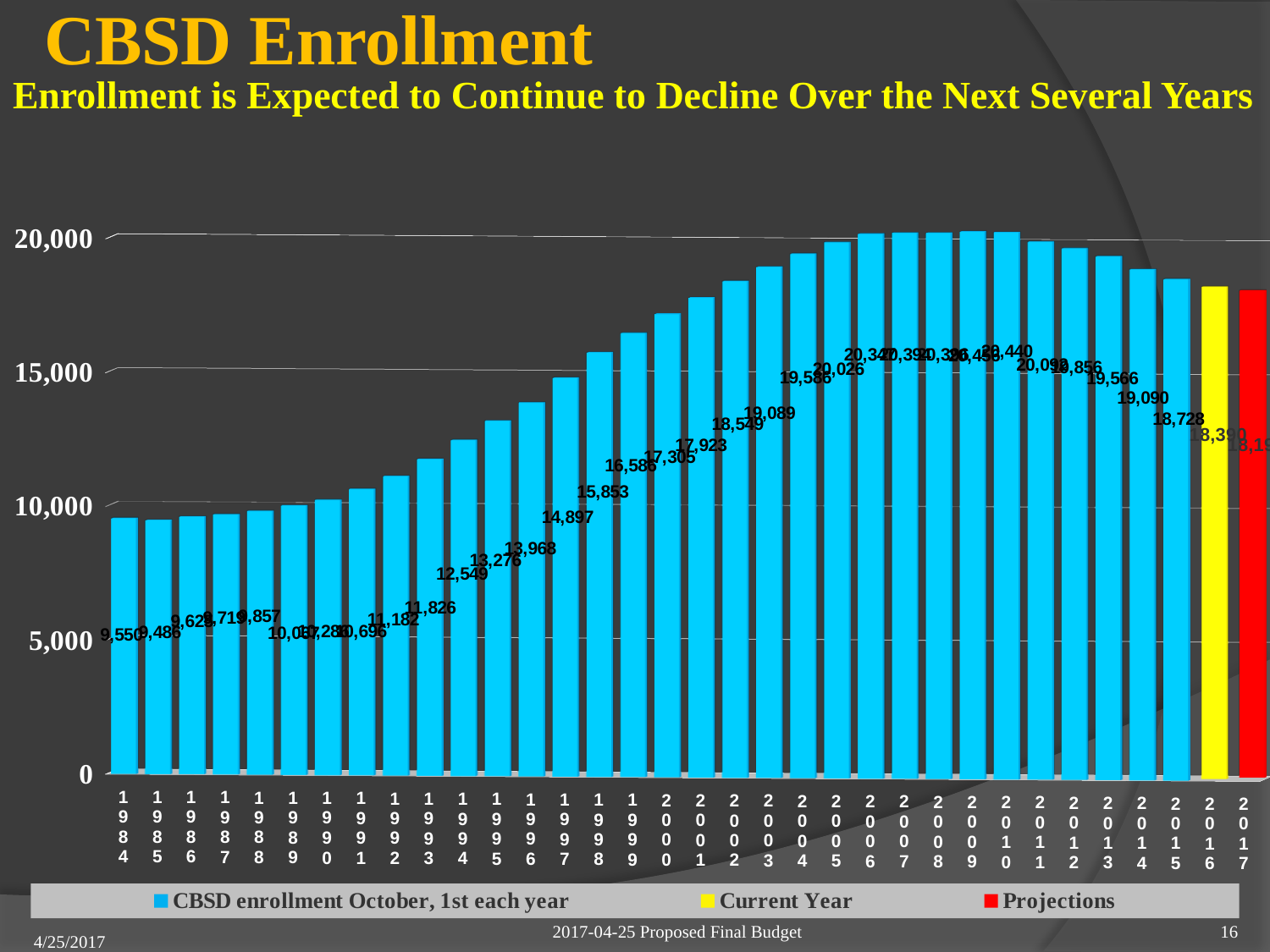
Is the value for 2016 greater or less than 15,000? greater What was the CBSD enrollment in 2010? 20,440 How many series does the legend list? 3 How many years are shown on the x axis? 34 Do the enrollment values rise or fall from 2010 to 2017? fall What was the CBSD enrollment in 1997? 14,897 What type of chart is shown on the slide? Bar chart What is the difference between the enrollment in 2014 and in 2015? 362 Which year had higher enrollment, 1998 or 2013? 2013 What was the CBSD enrollment in 1984? 9,550 What was the CBSD enrollment in 2015? 18,728 Which legend entry is shown in red? Projections